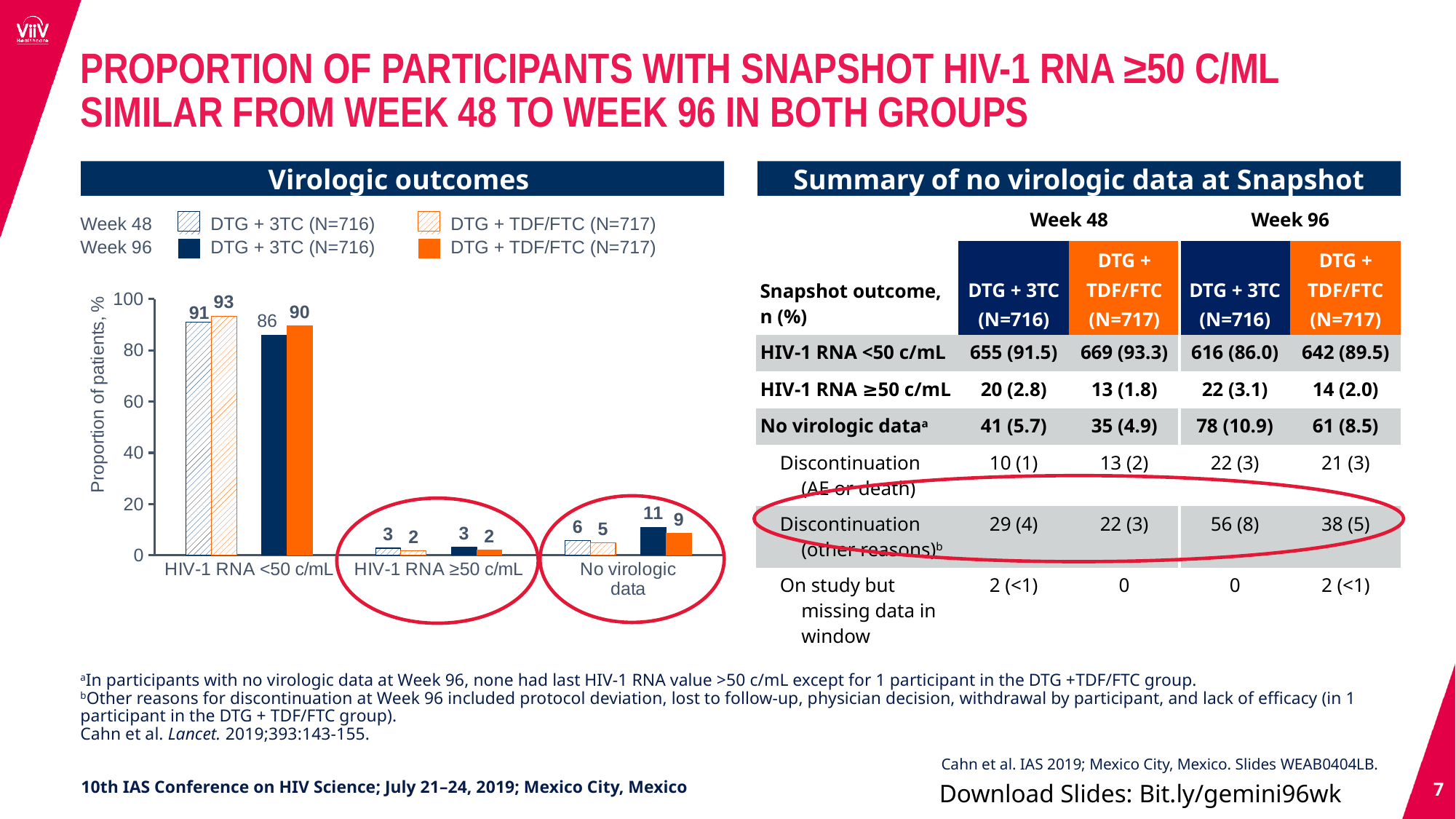
In the Virologic outcomes chart, what is the value for DTG + TDF/FTC at Week 48 in the HIV-1 RNA ≥50 c/mL category? 2 What kind of chart is the Virologic outcomes chart? Bar chart In the Virologic outcomes chart, what is the value for DTG + 3TC at Week 48 in the HIV-1 RNA <50 c/mL category? 91 How many series does the legend of the Virologic outcomes chart list? 4 In the Virologic outcomes chart, what is the difference between DTG + 3TC and DTG + TDF/FTC at Week 96 in the No virologic data category? 2 In the Virologic outcomes chart, which is larger in the HIV-1 RNA <50 c/mL category: DTG + 3TC at Week 48 or DTG + 3TC at Week 96? DTG + 3TC at Week 48 In the Virologic outcomes chart, what is the value for DTG + TDF/FTC at Week 96 in the HIV-1 RNA <50 c/mL category? 90 How many categories are shown on the x axis of the Virologic outcomes chart? 3 In the Virologic outcomes chart, which category has the highest value for DTG + 3TC at Week 96? HIV-1 RNA <50 c/mL In the Virologic outcomes chart, what is the difference between the Week 48 and Week 96 values for DTG + 3TC in the HIV-1 RNA <50 c/mL category? 5 In the Virologic outcomes chart, what is the value for DTG + 3TC at Week 96 in the No virologic data category? 11 In the Virologic outcomes chart, is the value for DTG + TDF/FTC at Week 96 in the HIV-1 RNA <50 c/mL category greater or less than 80? greater